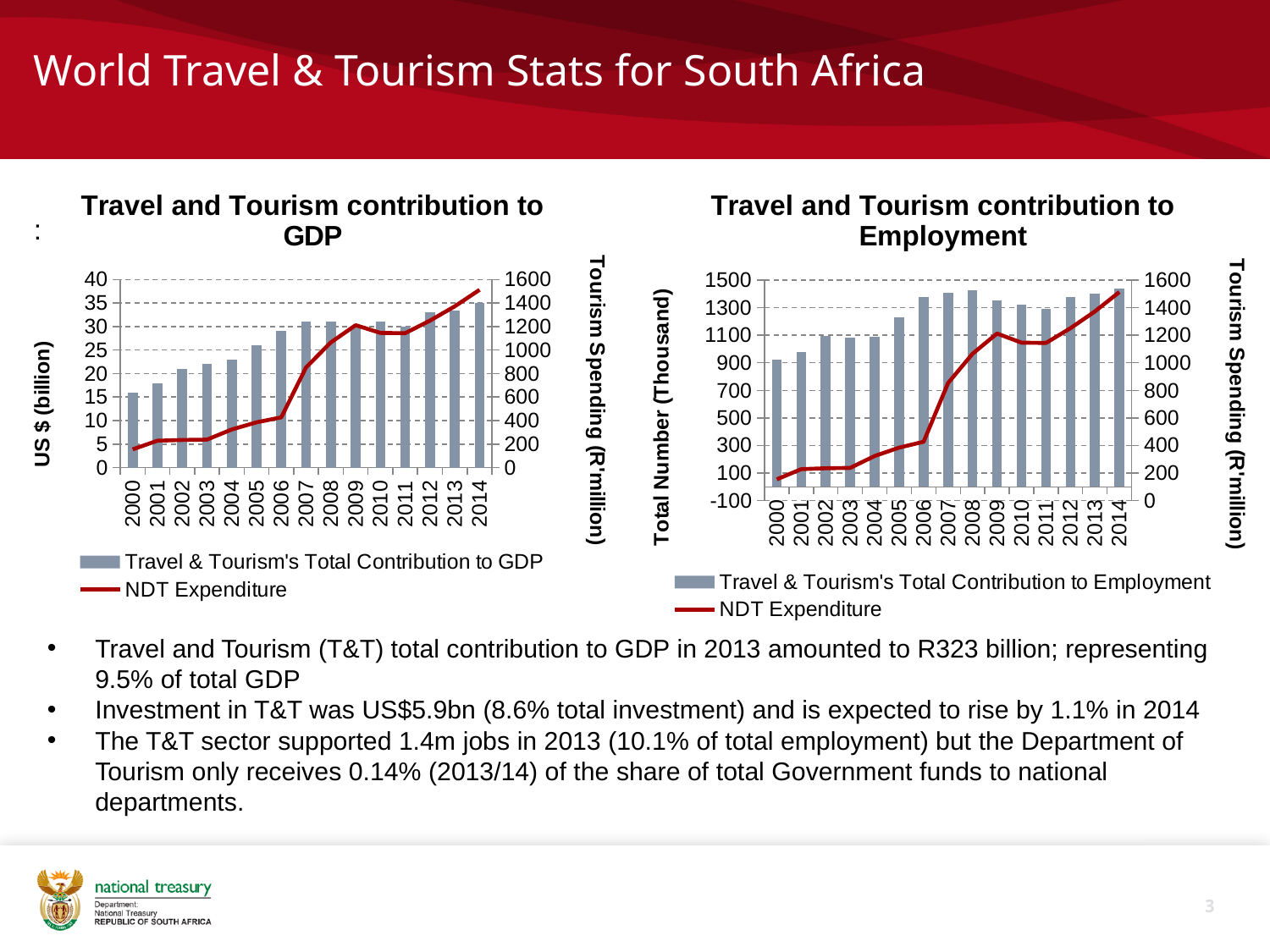
On the 'Travel and Tourism contribution to GDP' chart, which year has the highest bar for Travel & Tourism's Total Contribution to GDP? 2014 On the 'Travel and Tourism contribution to GDP' chart, how many years are shown on the x axis? 15 On the 'Travel and Tourism contribution to GDP' chart, which year has the lowest bar for Travel & Tourism's Total Contribution to GDP? 2000 On the 'Travel and Tourism contribution to Employment' chart, which year has the lowest bar? 2000 On the 'Travel and Tourism contribution to Employment' chart, which bar is taller, 2005 or 2006? 2006 On the 'Travel and Tourism contribution to GDP' chart, is the bar for 2000 greater or less than 20? less On the 'Travel and Tourism contribution to GDP' chart, does the NDT Expenditure line generally rise or fall from 2000 to 2014? rise On the 'Travel and Tourism contribution to GDP' chart, what kind of chart is used? Bar chart with a line On the 'Travel and Tourism contribution to GDP' chart, how many series does the legend list? 2 On the 'Travel and Tourism contribution to GDP' chart, is the bar for 2014 greater or less than 30? greater On the 'Travel and Tourism contribution to Employment' chart, what is the label of the right-hand vertical axis? Tourism Spending (R'million) On the 'Travel and Tourism contribution to Employment' chart, is the bar for 2008 greater or less than 1300? greater